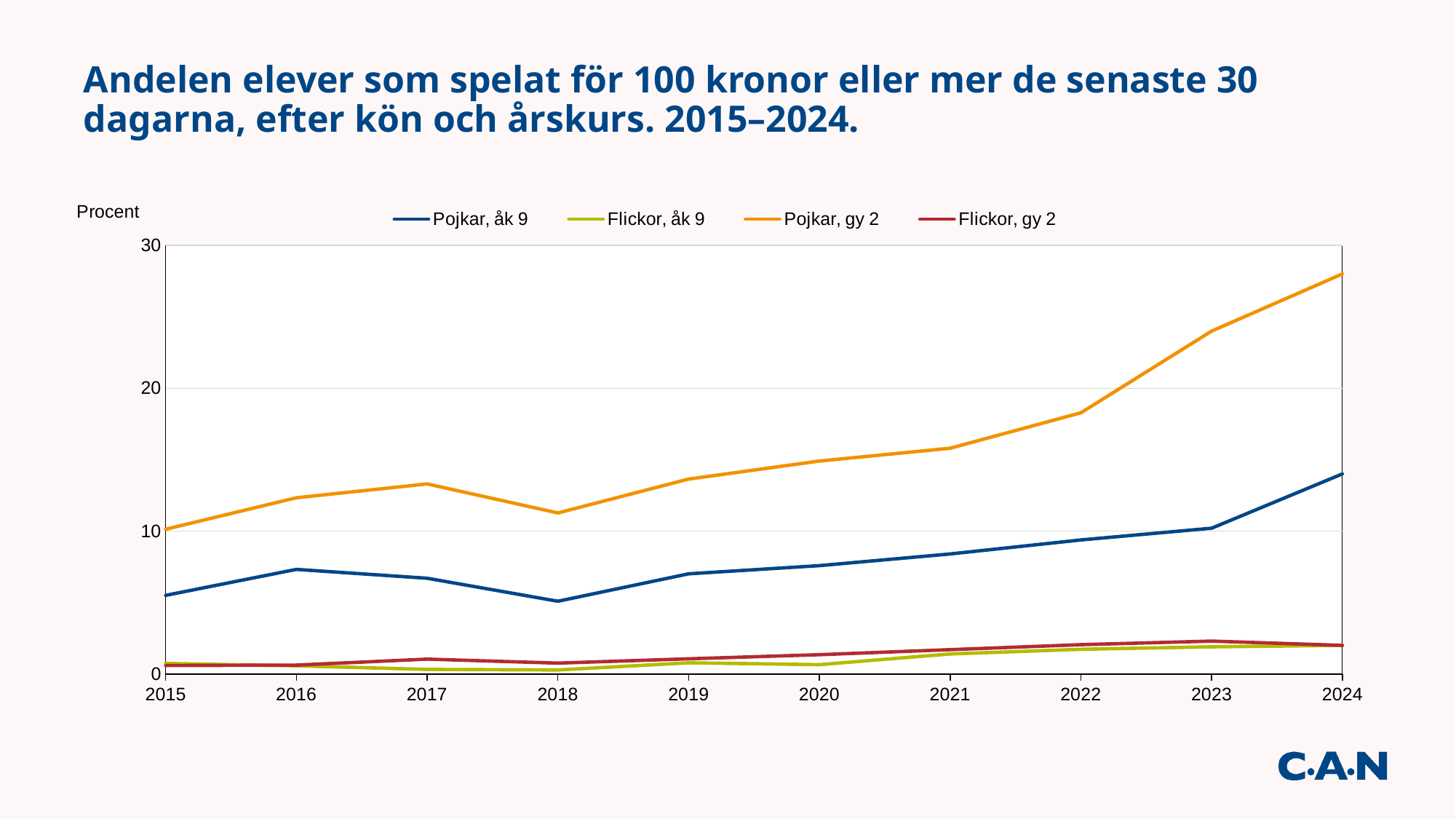
Which is larger in 2020, the value for Pojkar, gy 2 or the value for Pojkar, åk 9? Pojkar, gy 2 Is the value for Pojkar, åk 9 in 2018 greater or less than 10? less In which year does the Pojkar, gy 2 series reach its highest value? 2024 Does the Pojkar, gy 2 series generally rise or fall from 2018 to 2024? rise Is the value for Pojkar, åk 9 in 2024 greater or less than 10? greater Which series has the highest value in 2024? Pojkar, gy 2 What kind of chart is shown on the slide? line chart In which year is the Pojkar, gy 2 series at its lowest? 2015 How many years are plotted along the x axis? 10 What label is shown on the vertical axis of the chart? Procent Is the value for Pojkar, gy 2 in 2024 greater or less than 20? greater How many series does the legend list? 4